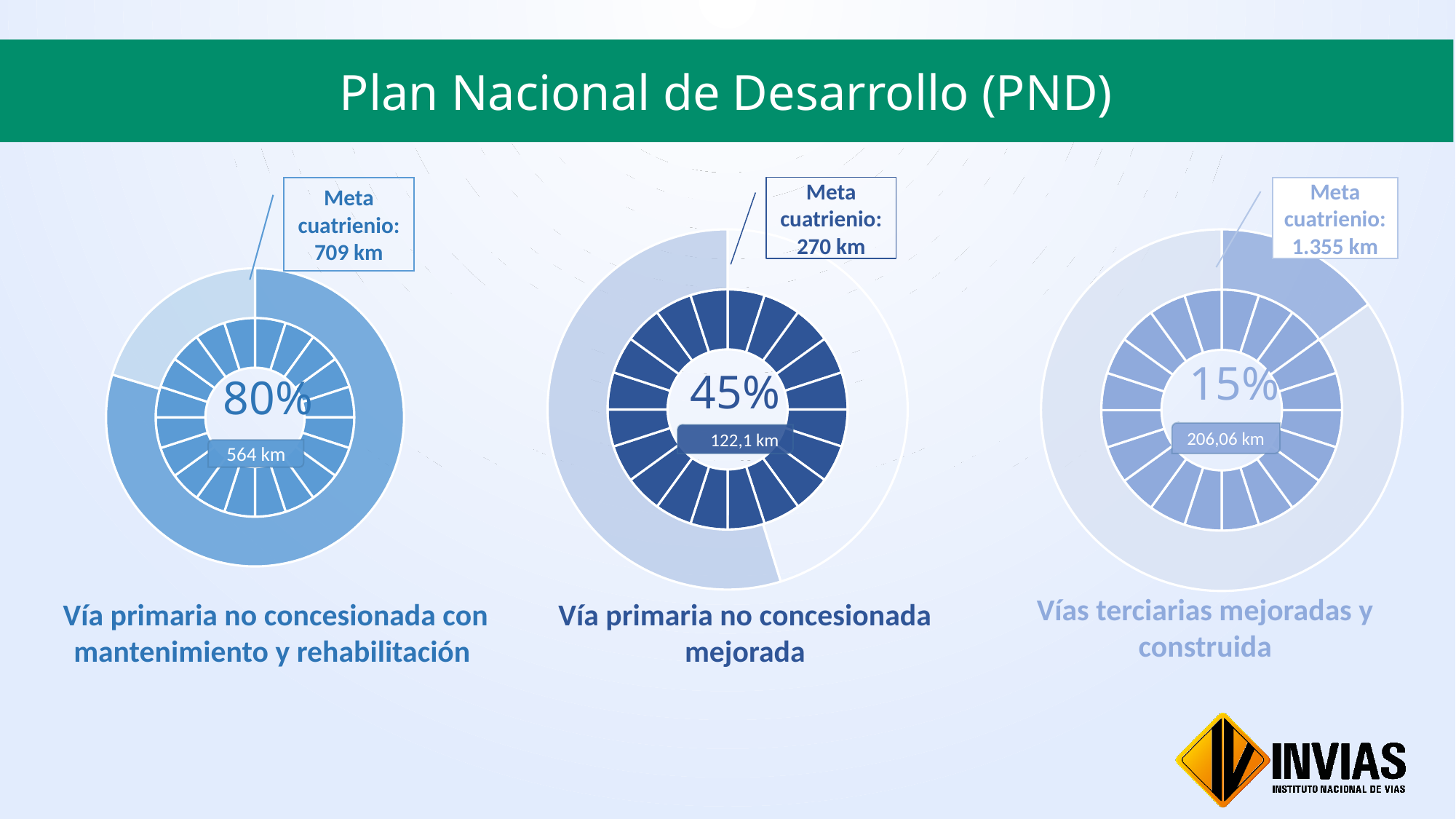
What percentage is shown in the centre of the chart titled 'Vía primaria no concesionada con mantenimiento y rehabilitación'? 80% What percentage is shown in the centre of the chart titled 'Vías terciarias mejoradas y construida'? 15% In the chart titled 'Vía primaria no concesionada mejorada', how many km have been achieved? 122,1 km Which of the three charts shows the highest percentage of progress? Vía primaria no concesionada con mantenimiento y rehabilitación What percentage is shown in the centre of the chart titled 'Vía primaria no concesionada mejorada'? 45% In the chart titled 'Vía primaria no concesionada con mantenimiento y rehabilitación', how many km remain to reach the 'Meta cuatrienio' of 709 km from the 564 km achieved? 145 km In the chart titled 'Vía primaria no concesionada con mantenimiento y rehabilitación', how many km have been achieved? 564 km In the chart titled 'Vías terciarias mejoradas y construida', how many km have been achieved? 206,06 km What is the 'Meta cuatrienio' for the chart titled 'Vías terciarias mejoradas y construida'? 1.355 km Which of the three charts shows the lowest percentage of progress? Vías terciarias mejoradas y construida Which is larger: the 'Meta cuatrienio' for 'Vía primaria no concesionada mejorada' or the 'Meta cuatrienio' for 'Vía primaria no concesionada con mantenimiento y rehabilitación'? Vía primaria no concesionada con mantenimiento y rehabilitación How many donut charts are shown on the slide? 3